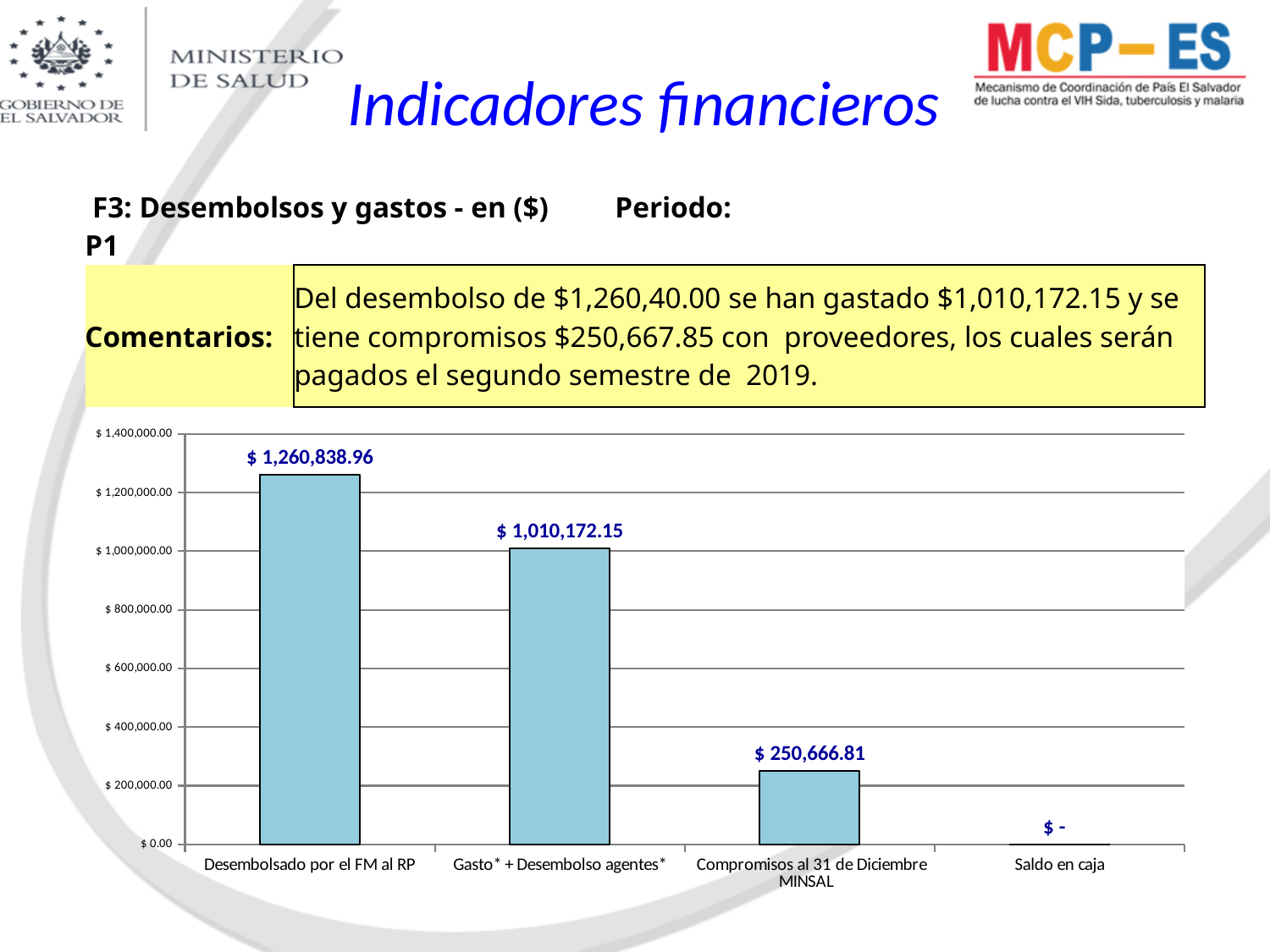
What is the difference between "Desembolsado por el FM al RP" and "Gasto* + Desembolso agentes*"? $ 250,666.81 Which is larger, "Gasto* + Desembolso agentes*" or "Compromisos al 31 de Diciembre MINSAL"? Gasto* + Desembolso agentes* Which category has the highest value? Desembolsado por el FM al RP What kind of chart is shown on the slide? bar chart Is the value for "Compromisos al 31 de Diciembre MINSAL" greater or less than $ 400,000.00? less What is the value for "Gasto* + Desembolso agentes*"? $ 1,010,172.15 What is the difference between "Gasto* + Desembolso agentes*" and "Compromisos al 31 de Diciembre MINSAL"? $ 759,505.34 Which category has the lowest value? Saldo en caja What is the data label shown for "Saldo en caja"? $ - What is the value for "Desembolsado por el FM al RP"? $ 1,260,838.96 How many categories are shown on the x axis? 4 What is the value for "Compromisos al 31 de Diciembre MINSAL"? $ 250,666.81